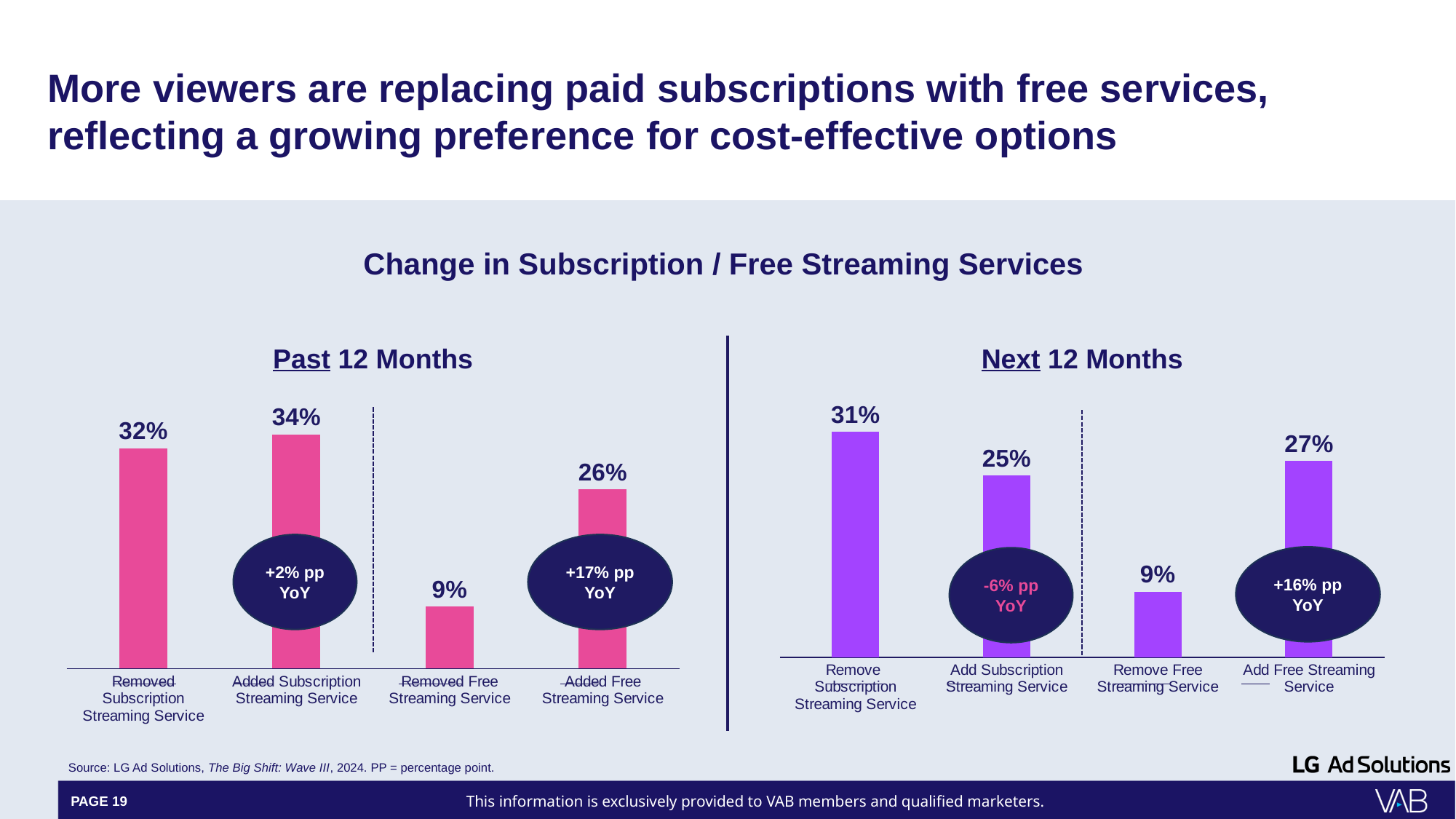
How many categories are shown in the Past 12 Months chart? 4 What type of chart is used for the Next 12 Months data? Bar chart In the Next 12 Months chart, which category has the lowest value? Remove Free Streaming Service In the Next 12 Months chart, which is larger: Add Free Streaming Service or Add Subscription Streaming Service? Add Free Streaming Service In the Past 12 Months chart, what is the value for Removed Free Streaming Service? 9% In the Next 12 Months chart, what is the value for Add Free Streaming Service? 27% In the Next 12 Months chart, what is the difference between Remove Subscription Streaming Service and Add Subscription Streaming Service? 6 percentage points In the Past 12 Months chart, what is the difference between Added Free Streaming Service and Removed Free Streaming Service? 17 percentage points In the Past 12 Months chart, what is the value for Added Subscription Streaming Service? 34% In the Next 12 Months chart, what is the value for Remove Subscription Streaming Service? 31% In the Next 12 Months chart, what YoY change is shown in the circle for Add Subscription Streaming Service? -6% pp YoY In the Past 12 Months chart, which category has the highest value? Added Subscription Streaming Service